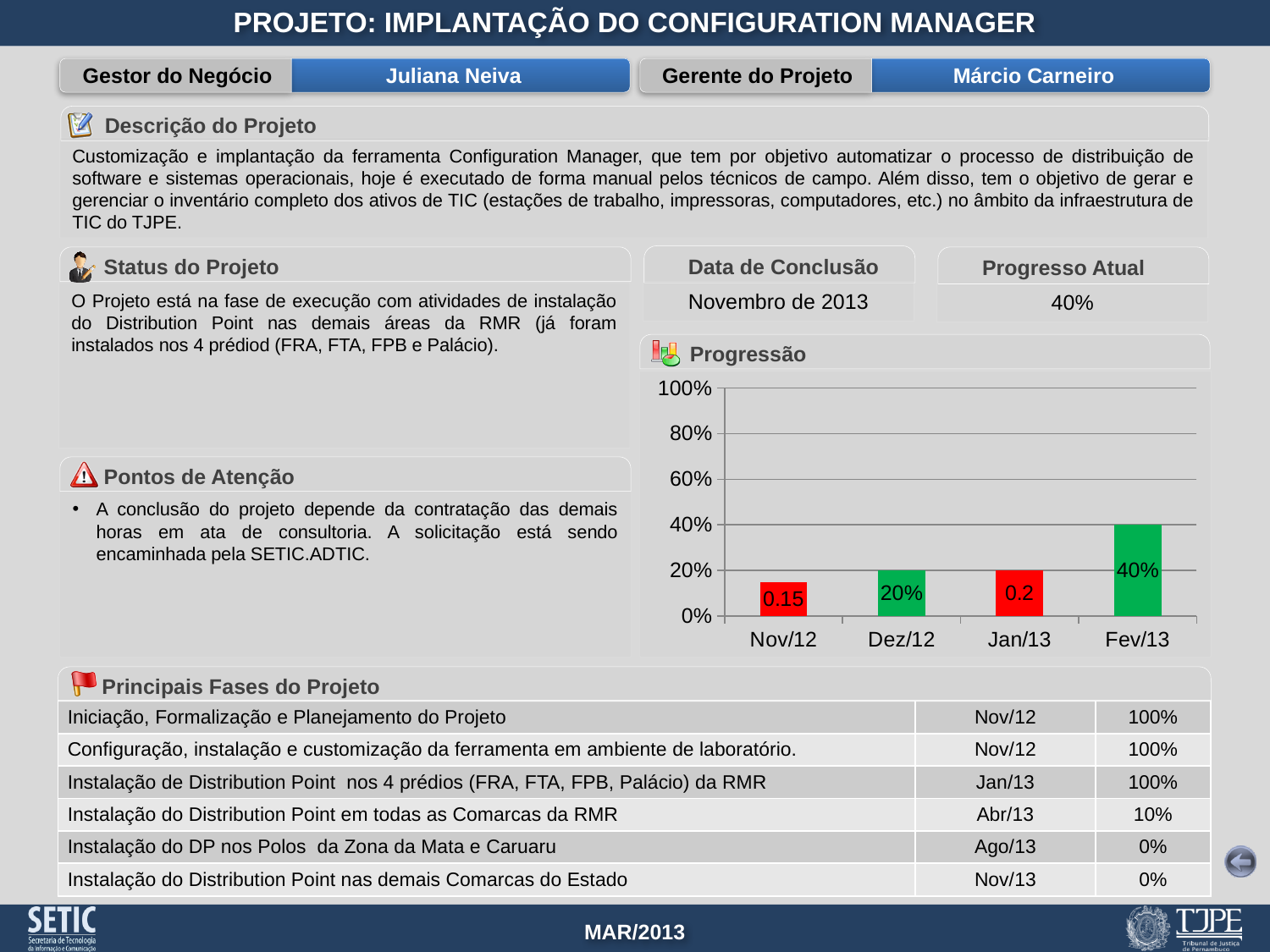
What value is shown for Nov/12 in the Progressão chart? 0.15 Which month has the highest value in the Progressão chart? Fev/13 In the Progressão chart, is the value for Fev/13 greater or less than 20%? greater In the Progressão chart, which is larger: the value for Fev/13 or the value for Dez/12? Fev/13 What value is shown for Jan/13 in the Progressão chart? 0.2 What colour is the Fev/13 bar in the Progressão chart? green What kind of chart is the Progressão chart? bar chart How many months are shown on the x axis of the Progressão chart? 4 What value is shown for Fev/13 in the Progressão chart? 40% What value is shown for Dez/12 in the Progressão chart? 20% In the Progressão chart, what is the difference between the values for Fev/13 and Dez/12? 20% Which month has the lowest value in the Progressão chart? Nov/12